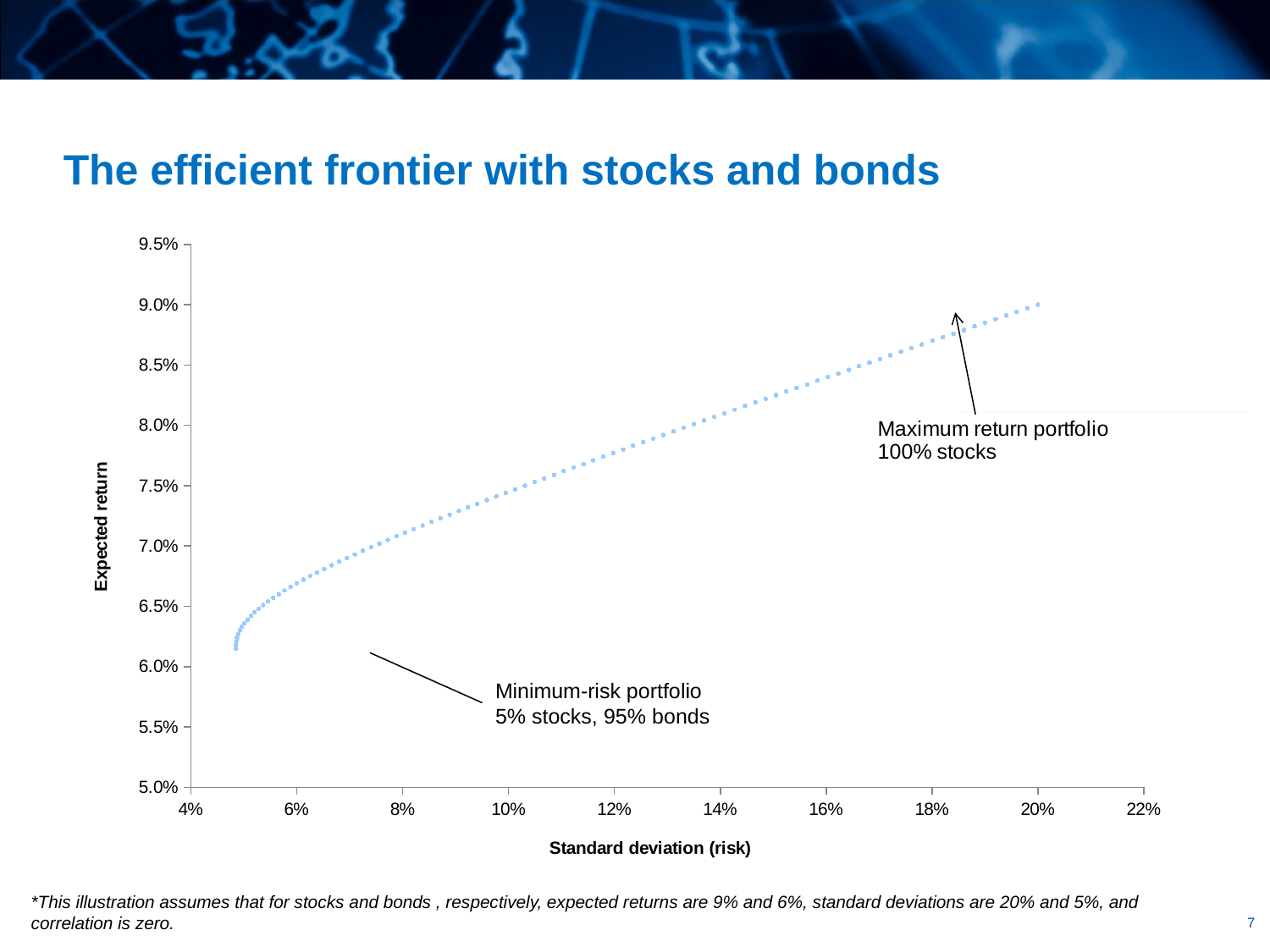
According to the chart annotation, what is the composition of the minimum-risk portfolio? 5% stocks, 95% bonds Does expected return rise or fall as standard deviation increases along the x axis? Rise What is the expected return of the maximum return portfolio (100% stocks)? 9.0% Which portfolio has the higher expected return, the minimum-risk portfolio or the maximum return portfolio? Maximum return portfolio Is the expected return of the minimum-risk portfolio greater or less than 6.5%? less Is the standard deviation of the minimum-risk portfolio greater or less than 6%? less Is the expected return at a standard deviation of 16% greater or less than 8.0%? greater What is the standard deviation of the maximum return portfolio (100% stocks)? 20% What is the title of the chart's x axis? Standard deviation (risk) What kind of chart is shown on the slide? Scatter chart